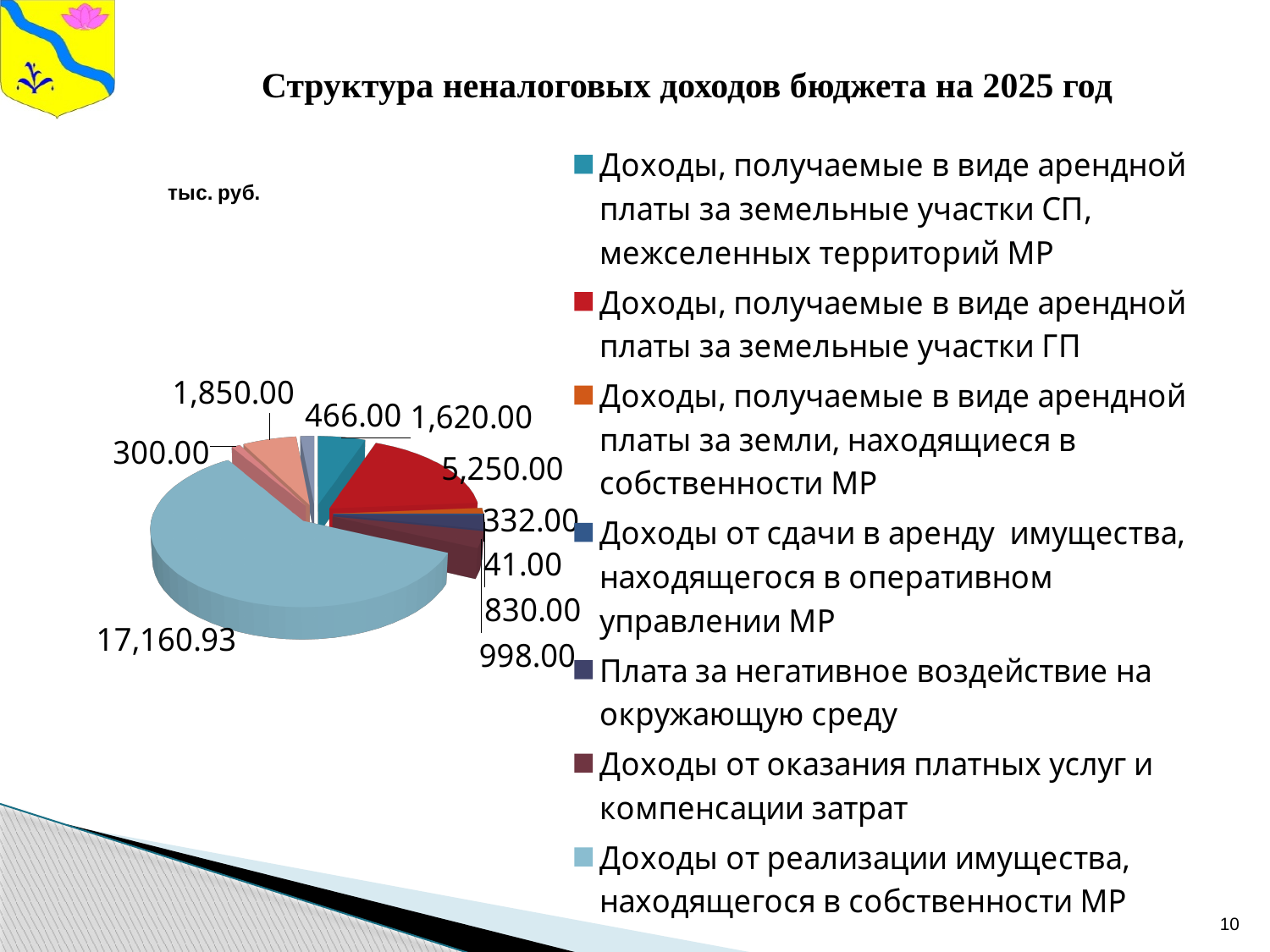
What is the largest value shown on the pie chart? 17,160.93 How many slices does the pie chart have? 10 Which is larger: the value for 'Доходы, получаемые в виде арендной платы за земельные участки ГП' or the value for 'Доходы, получаемые в виде арендной платы за земельные участки СП, межселенных территорий МР'? Доходы, получаемые в виде арендной платы за земельные участки ГП How many entries are listed in the legend? 7 What type of chart is shown on the slide? Pie chart What is the smallest value shown on the pie chart? 41.00 What is the value for 'Доходы, получаемые в виде арендной платы за земельные участки СП, межселенных территорий МР'? 1,620.00 What is the value for 'Доходы от реализации имущества, находящегося в собственности МР'? 17,160.93 What is the title of the slide's chart? Структура неналоговых доходов бюджета на 2025 год What unit is indicated above the pie chart? тыс. руб. What is the difference between the value for 'Доходы, получаемые в виде арендной платы за земельные участки ГП' (5,250.00) and the value for 'Доходы, получаемые в виде арендной платы за земельные участки СП, межселенных территорий МР' (1,620.00)? 3,630.00 What is the value for 'Доходы, получаемые в виде арендной платы за земельные участки ГП'? 5,250.00